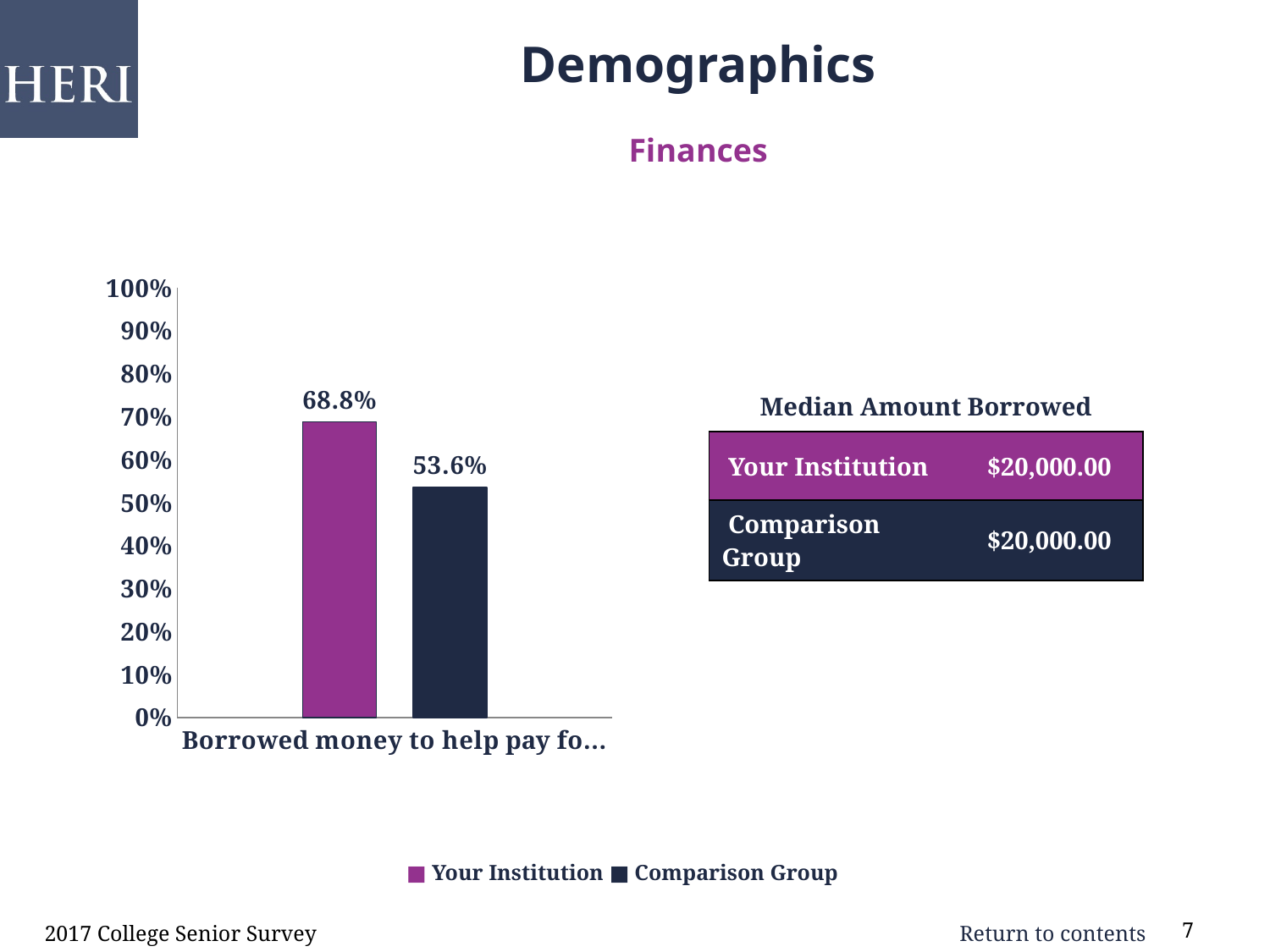
What is the difference between the Your Institution and Comparison Group values in the bar chart? 15.2% Is the value for Comparison Group greater or less than 60%? less What kind of chart is shown on the slide? Bar chart Which series has the higher value in the bar chart? Your Institution What is the value for Comparison Group in the bar chart? 53.6% How many series does the legend list? 2 What is the maximum value shown on the y axis of the bar chart? 100% What is the value for Your Institution in the bar chart? 68.8% What colour is the Your Institution bar? Purple Which series has the lower value in the bar chart? Comparison Group Is the value for Your Institution greater or less than 60%? greater